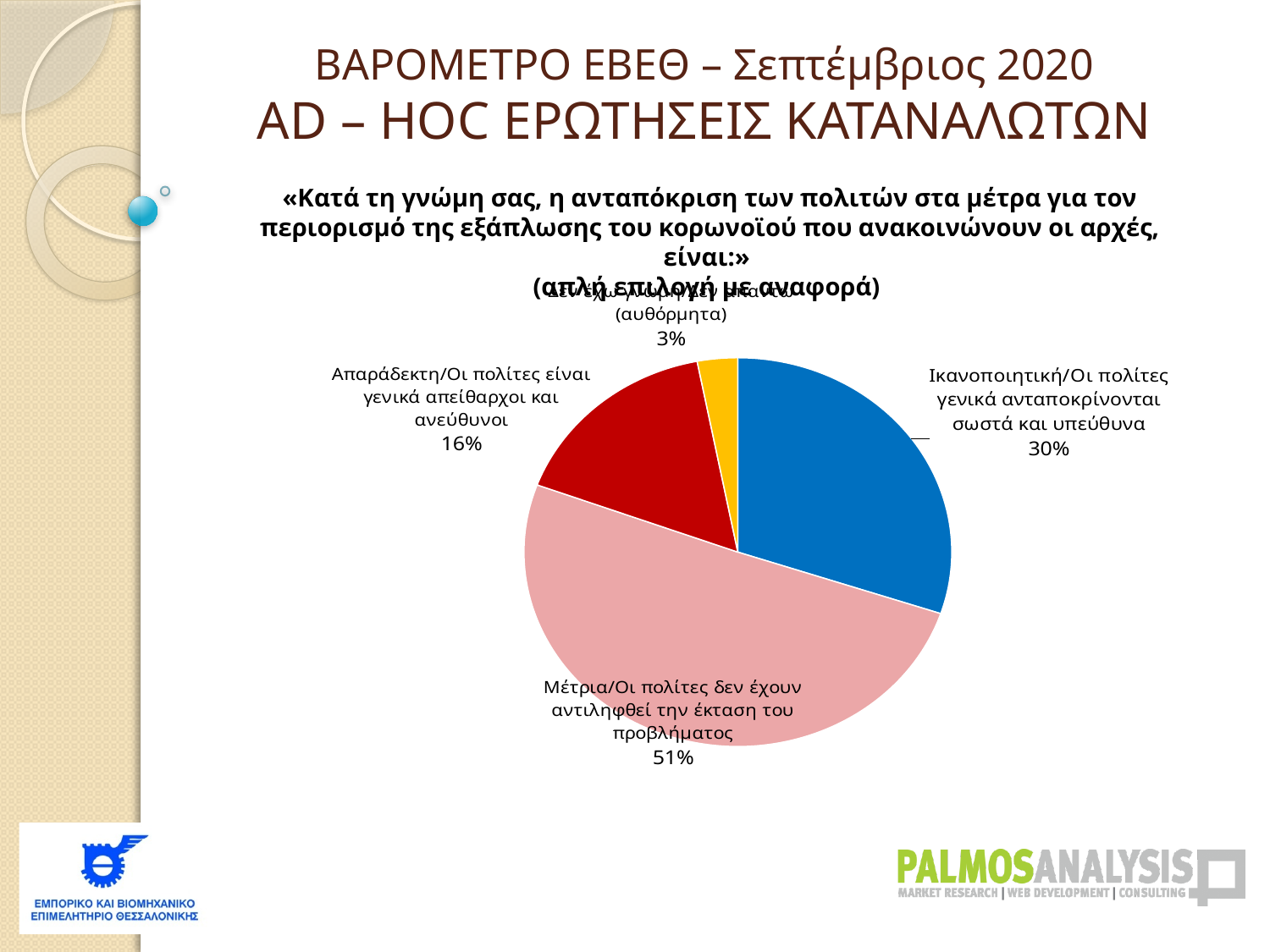
Which response has the smallest share of the pie? Δεν έχω γνώμη/Δεν απαντώ (αυθόρμητα) Which is larger: the share for «Ικανοποιητική» or the share for «Απαράδεκτη»? Ικανοποιητική What is the combined share of the «Ικανοποιητική» and «Απαράδεκτη» responses? 46% How many slices does the pie chart have? 4 What colour is the slice representing the «Μέτρια» response? pink What kind of chart is shown on the slide? pie chart What percentage of respondents answered «Απαράδεκτη/Οι πολίτες είναι γενικά απείθαρχοι και ανεύθυνοι»? 16% What percentage of respondents answered «Μέτρια/Οι πολίτες δεν έχουν αντιληφθεί την έκταση του προβλήματος»? 51% What is the difference in percentage points between the «Μέτρια» response and the «Ικανοποιητική» response? 21 What percentage is shown for the yellow slice labelled «(αυθόρμητα)»? 3% Which response has the largest share of the pie? Μέτρια/Οι πολίτες δεν έχουν αντιληφθεί την έκταση του προβλήματος What percentage of respondents answered «Ικανοποιητική/Οι πολίτες γενικά ανταποκρίνονται σωστά και υπεύθυνα»? 30%